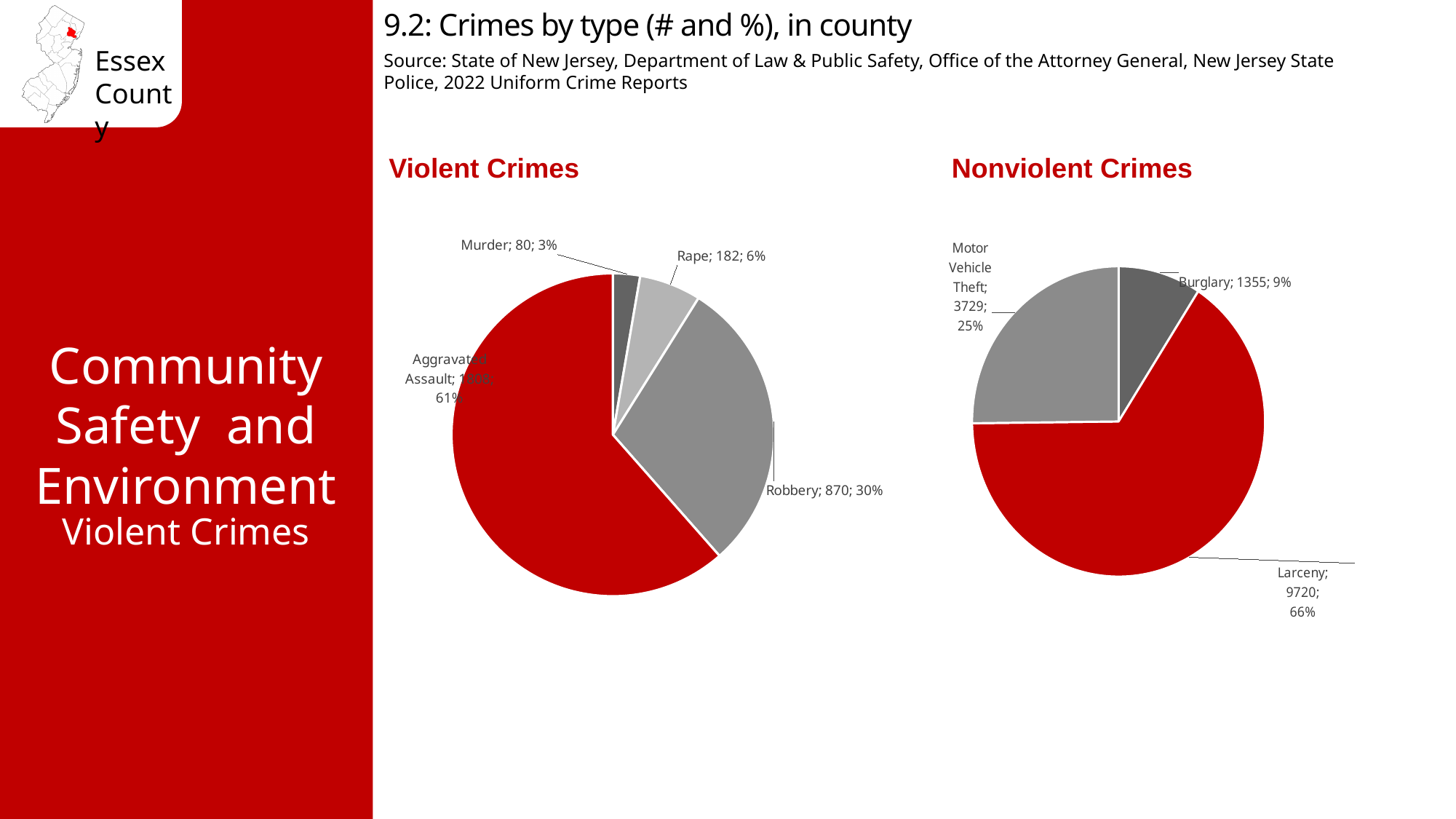
What type of charts are shown on the slide? Pie charts In the Nonviolent Crimes chart, how many crime categories are shown? 3 In the Violent Crimes chart, what is the difference between the number of robberies and the number of rapes? 688 In the Violent Crimes chart, what share of violent crimes is rape? 6% In the Violent Crimes chart, how many robberies are shown? 870 In the Nonviolent Crimes chart, how many larcenies are shown? 9720 In the Violent Crimes chart, which crime type has the smallest slice? Murder In the Nonviolent Crimes chart, what is the difference between the number of motor vehicle thefts and burglaries? 2374 In the Nonviolent Crimes chart, what share of nonviolent crimes is motor vehicle theft? 25% In the Nonviolent Crimes chart, which crime type has the smallest slice? Burglary In the Violent Crimes chart, how many murders are shown? 80 In the Violent Crimes chart, which crime type has the largest slice? Aggravated Assault